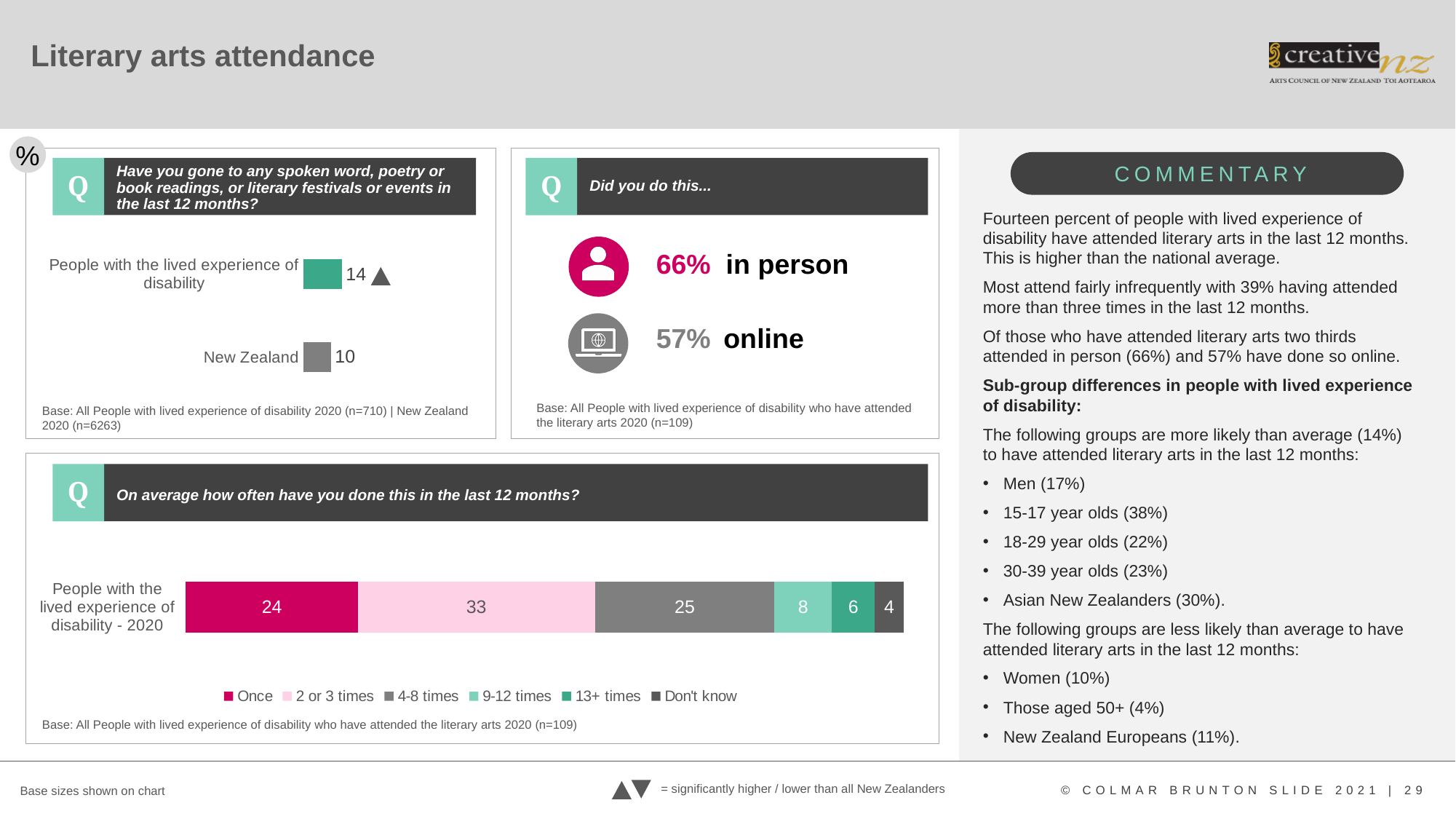
In the top-left chart on attendance in the last 12 months, how many categories are shown? 2 What kind of chart is the bottom chart on how often people have done this in the last 12 months? Stacked bar chart In the top-left chart on attendance in the last 12 months, which category has the higher value? People with the lived experience of disability In the top-left chart on attendance in the last 12 months, what is the value for People with the lived experience of disability? 14 In the top-left chart on attendance in the last 12 months, what is the value for New Zealand? 10 In the bottom stacked bar chart on frequency, how many series does the legend list? 6 In the top-left chart on attendance in the last 12 months, what is the difference between the value for People with the lived experience of disability and the value for New Zealand? 4 In the bottom stacked bar chart on frequency, what is the value for the '13+ times' segment? 6 In the bottom stacked bar chart on frequency, what is the value for the '2 or 3 times' segment? 33 In the bottom stacked bar chart on frequency, what is the value for the 'Once' segment? 24 In the bottom stacked bar chart on frequency, what is the total of all segments in the bar for People with the lived experience of disability - 2020? 100 In the bottom stacked bar chart on frequency, which segment has the largest value? 2 or 3 times